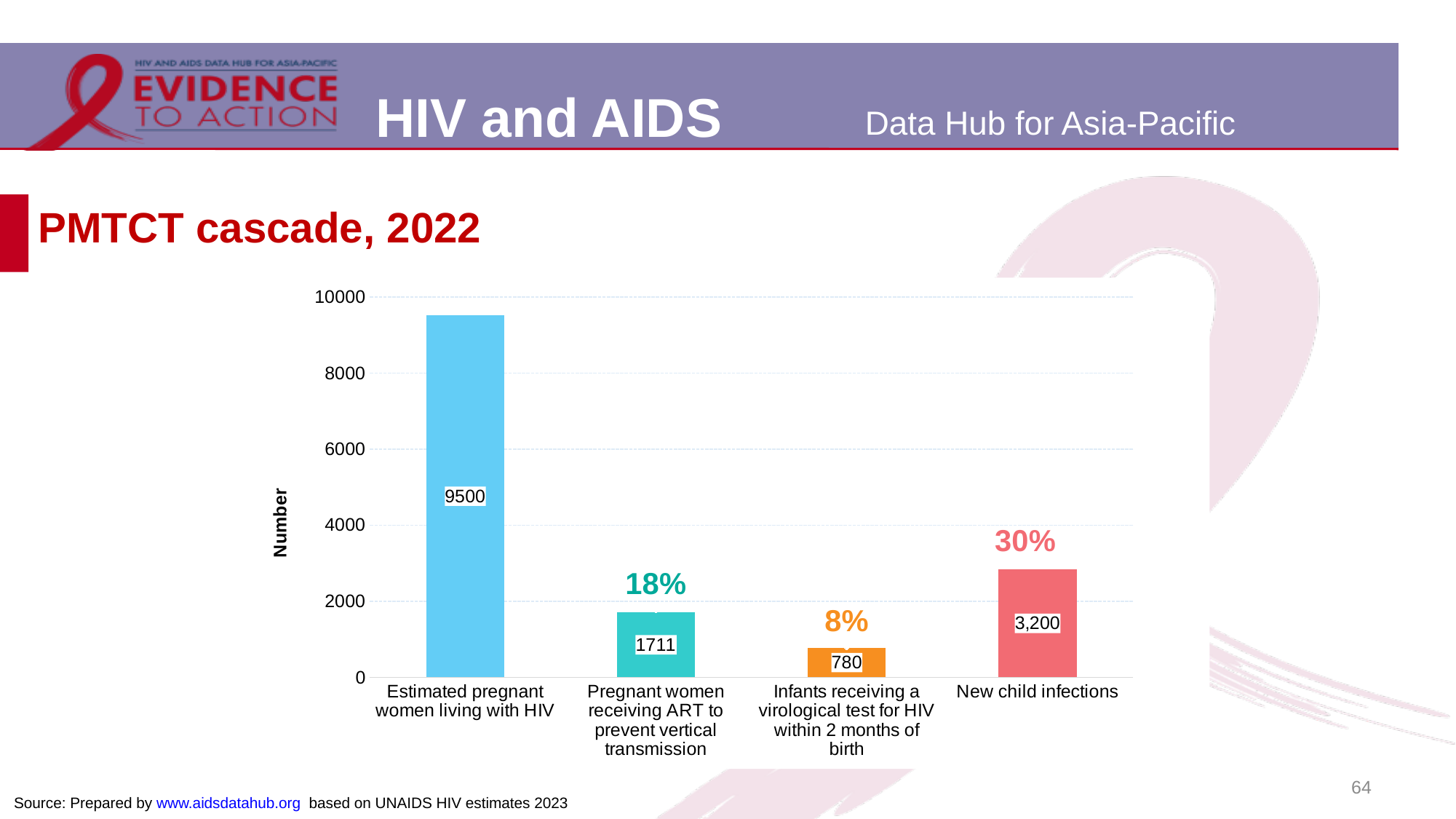
Which category has the highest value? Estimated pregnant women living with HIV What is the value for Estimated pregnant women living with HIV? 9500 Which is larger: New child infections or Pregnant women receiving ART to prevent vertical transmission? New child infections What kind of chart is shown on the slide? Bar chart What is the value for Infants receiving a virological test for HIV within 2 months of birth? 780 What is the value for Pregnant women receiving ART to prevent vertical transmission? 1711 What percentage is shown above the New child infections bar? 30% What is the value for New child infections? 3,200 Which category has the lowest value? Infants receiving a virological test for HIV within 2 months of birth How many categories are shown on the chart? 4 What is the title of the chart? PMTCT cascade, 2022 What is the difference between Estimated pregnant women living with HIV and Pregnant women receiving ART to prevent vertical transmission? 7789